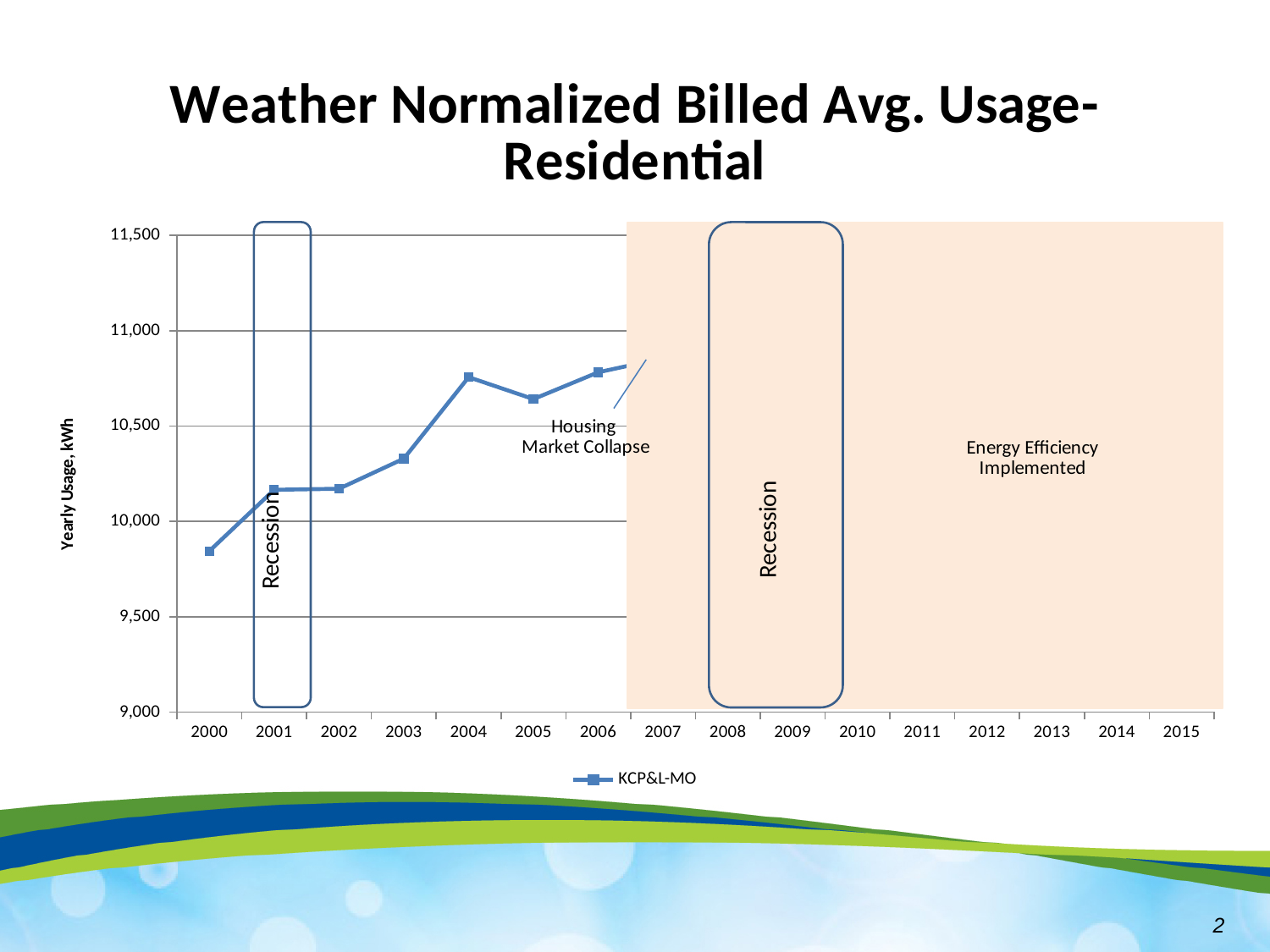
Is the value for 2002 greater or less than 10,000? greater Is the value for 2004 greater or less than 10,500? greater Which is larger, the value for 2004 or the value for 2005? 2004 What is the name of the series shown in the legend? KCP&L-MO Is the value for 2000 greater or less than 10,000? less How many series does the legend list? 1 Does the plotted usage rise or fall from 2000 to 2004? Rise What is the label on the vertical axis? Yearly Usage, kWh What kind of chart is shown on the slide? Line chart Which year has the lowest plotted value? 2000 How many years are labeled along the x axis? 16